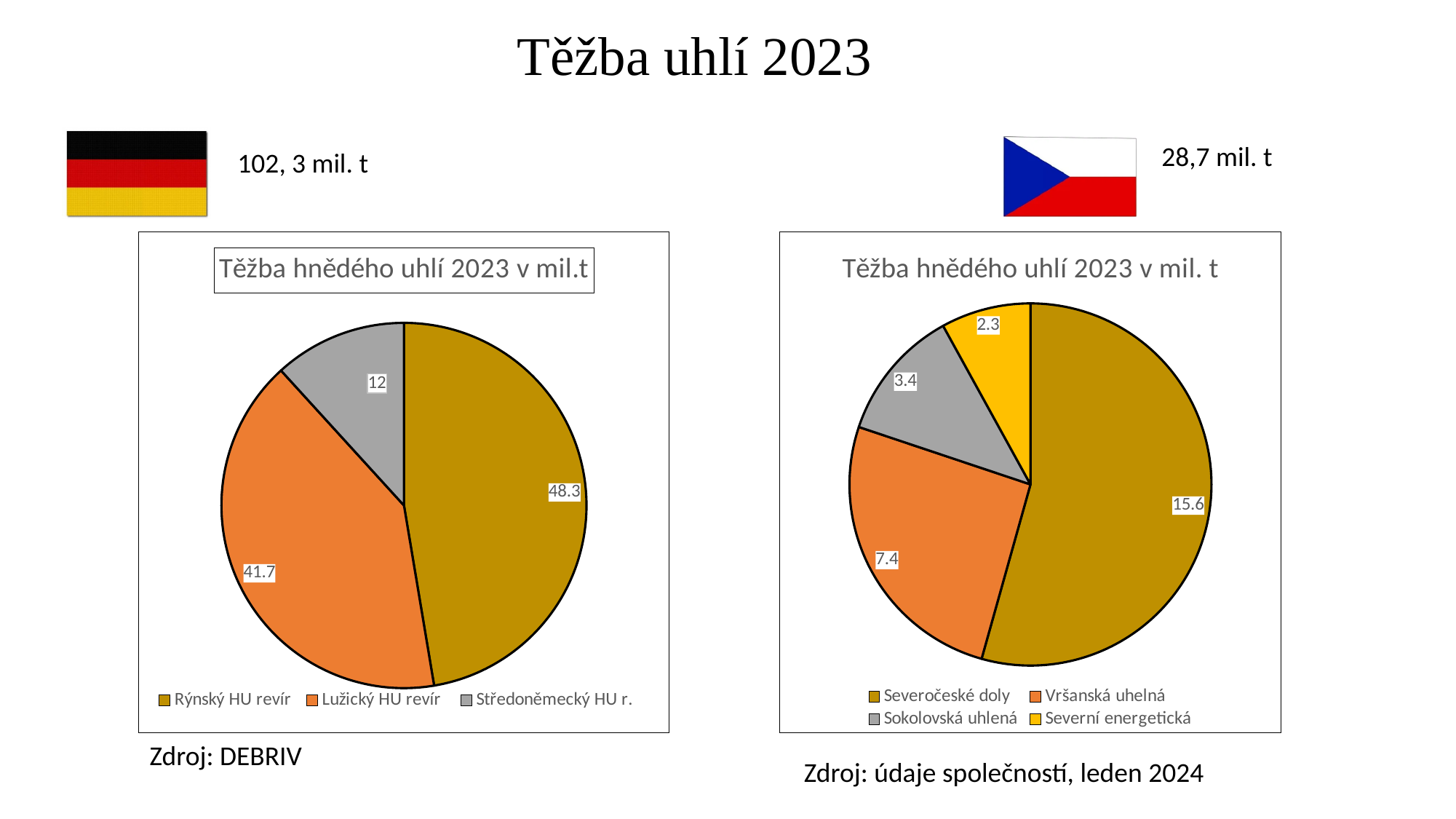
In the right pie chart, which is larger: Sokolovská uhlená or Severní energetická? Sokolovská uhlená In the left pie chart, what is the value for Středoněmecký HU r.? 12 In the left pie chart, what is the difference between the values for Rýnský HU revír and Lužický HU revír? 6.6 What type of chart is the left chart? Pie chart How many categories does the right pie chart show? 4 What is the title of the right chart? Těžba hnědého uhlí 2023 v mil. t In the left pie chart, which category has the smallest slice? Středoněmecký HU r. In the right pie chart, which category has the largest slice? Severočeské doly In the right pie chart, what is the value for Severní energetická? 2.3 In the right pie chart, what is the value for Vršanská uhelná? 7.4 In the right pie chart, what is the difference between the values for Severočeské doly and Sokolovská uhlená? 12.2 In the left pie chart, what is the value for Rýnský HU revír? 48.3